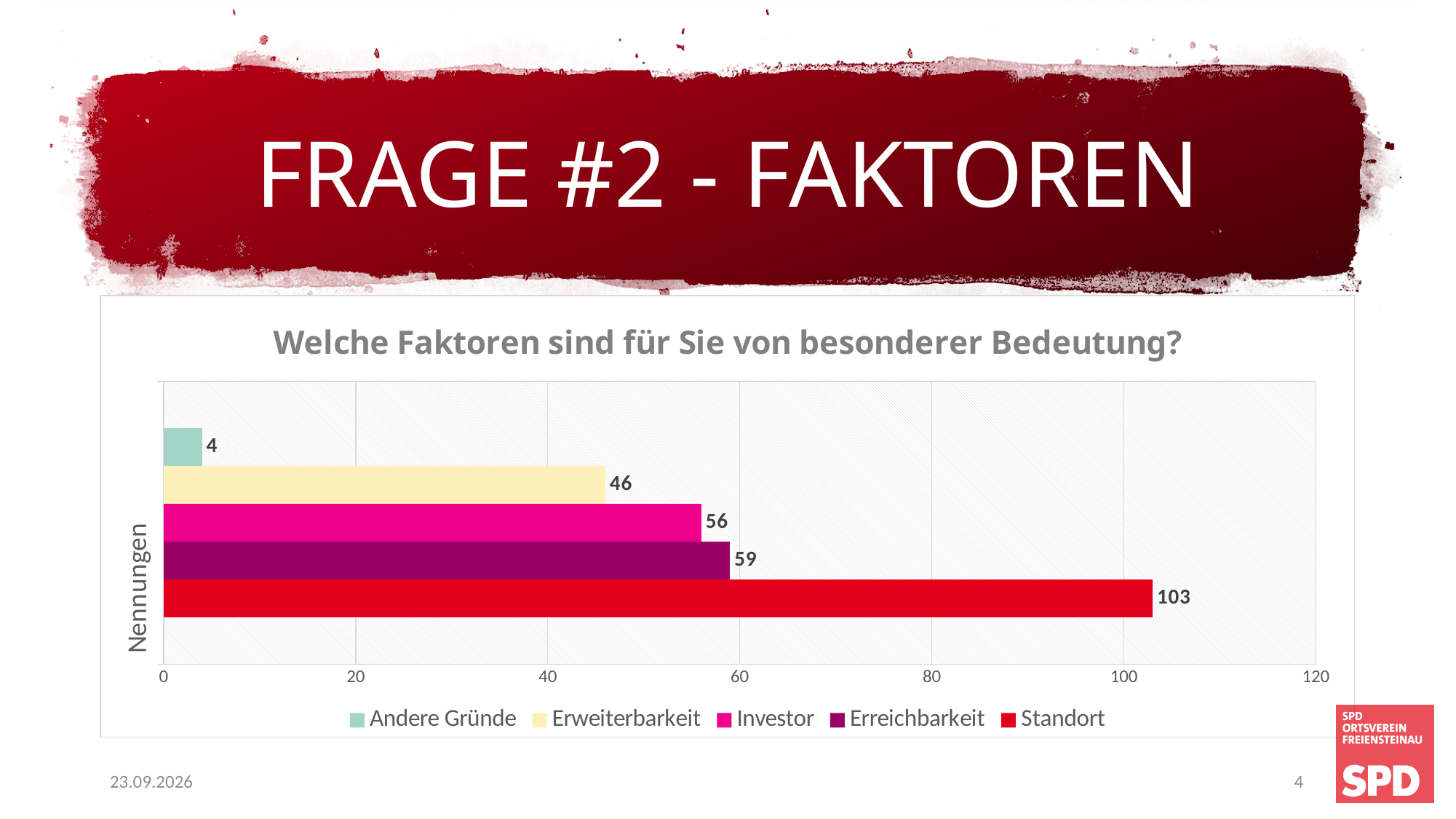
Which factor has the highest number of Nennungen? Standort What is the title of the chart? Welche Faktoren sind für Sie von besonderer Bedeutung? What is the difference between the values for Standort and Erreichbarkeit? 44 What kind of chart is shown on the slide? bar chart What is the value for Andere Gründe? 4 Is the value for Standort greater or less than 100? greater Which is larger, the value for Erreichbarkeit or the value for Investor? Erreichbarkeit Which factor has the lowest number of Nennungen? Andere Gründe How many series does the legend list? 5 What is the value for Standort? 103 What is the difference between the values for Investor and Erweiterbarkeit? 10 What is the value for Erweiterbarkeit? 46